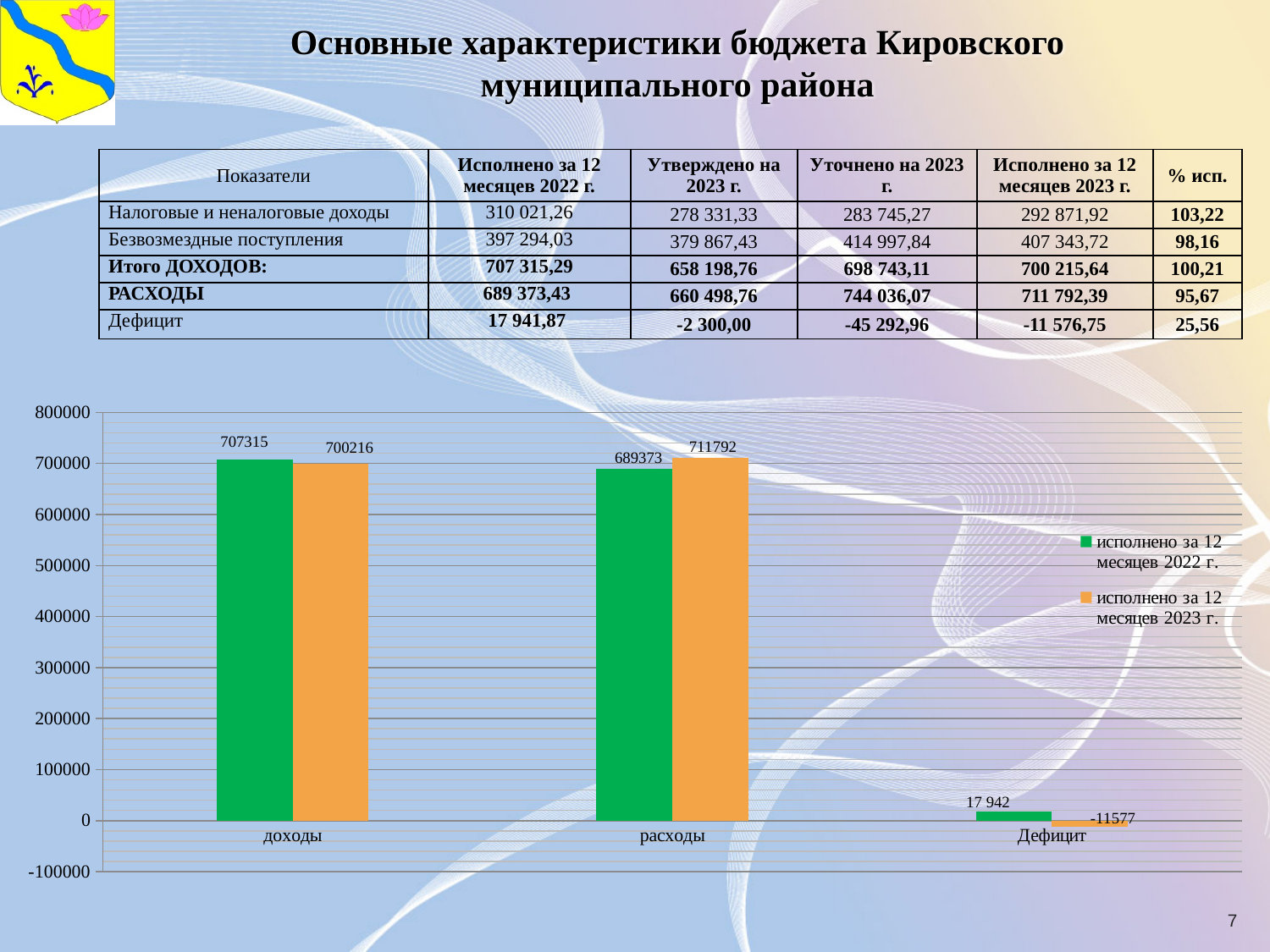
How many series does the chart legend list? 2 What is the value for расходы in the series исполнено за 12 месяцев 2022 г.? 689373 What is the difference between the 2023 and 2022 values for расходы (711792 minus 689373)? 22419 What is the value for доходы in the series исполнено за 12 месяцев 2023 г.? 700216 What is the value for доходы in the series исполнено за 12 месяцев 2022 г.? 707315 How many categories are shown on the x axis of the chart? 3 What kind of chart is shown on the slide? bar chart Which category has the highest value in the series исполнено за 12 месяцев 2023 г.? расходы Which category has the lowest value in the series исполнено за 12 месяцев 2022 г.? Дефицит What is the value for Дефицит in the series исполнено за 12 месяцев 2023 г.? -11577 What is the value for расходы in the series исполнено за 12 месяцев 2023 г.? 711792 Which series is shown in green in the chart? исполнено за 12 месяцев 2022 г.